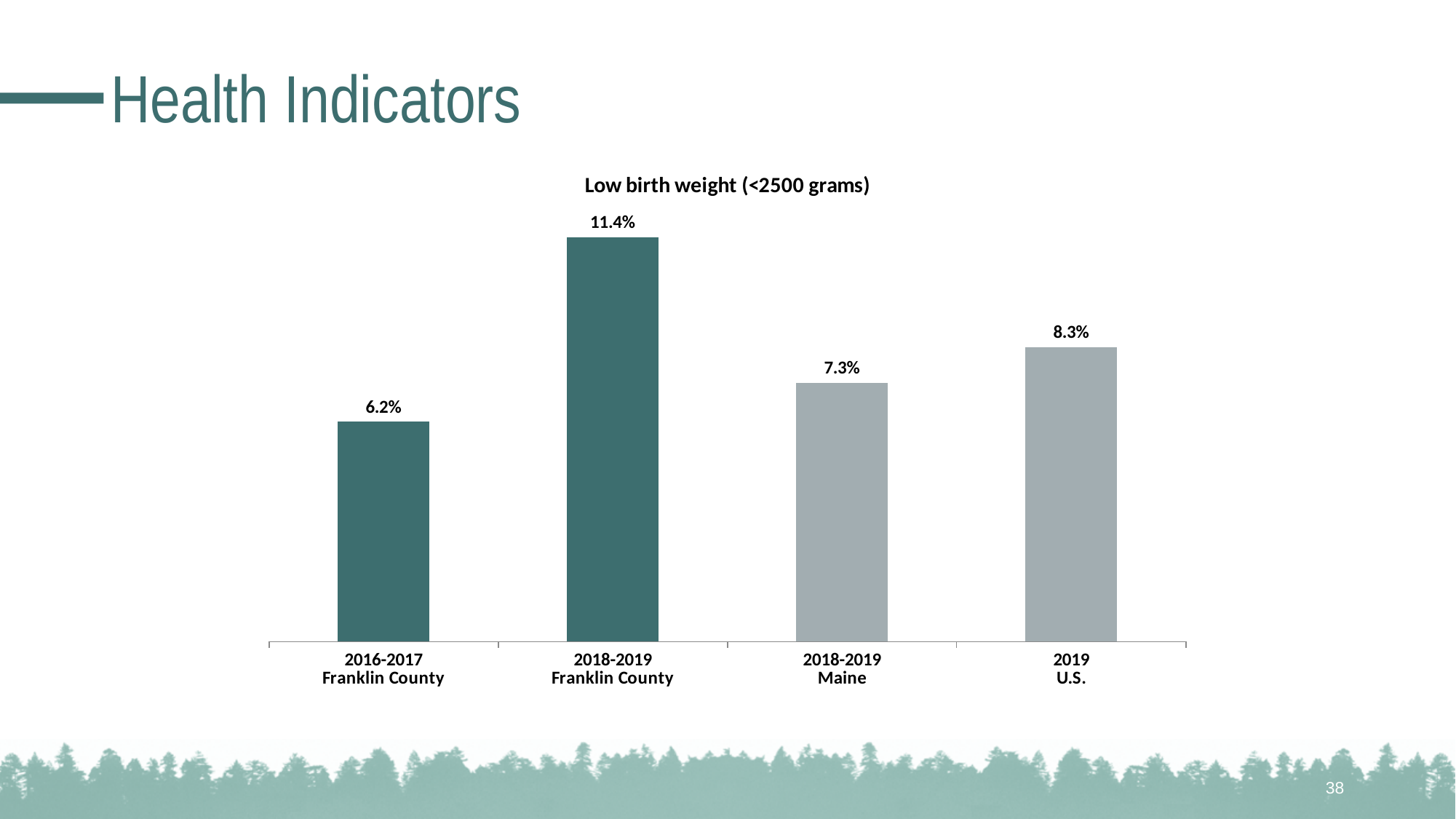
What kind of chart is shown on the slide? Bar chart What is the title of the chart? Low birth weight (<2500 grams) What is the low birth weight value for 2019 U.S.? 8.3% How many categories are shown in the chart? 4 What is the low birth weight value for 2018-2019 Maine? 7.3% What is the difference between the 2018-2019 Franklin County value and the 2016-2017 Franklin County value? 5.2% What is the difference between the 2019 U.S. value and the 2018-2019 Maine value? 1.0% Which category has the lowest low birth weight percentage? 2016-2017 Franklin County What is the low birth weight value for 2016-2017 Franklin County? 6.2% What is the low birth weight value for 2018-2019 Franklin County? 11.4% Which category has the highest low birth weight percentage? 2018-2019 Franklin County Which is larger, the value for 2018-2019 Maine or the value for 2019 U.S.? 2019 U.S.